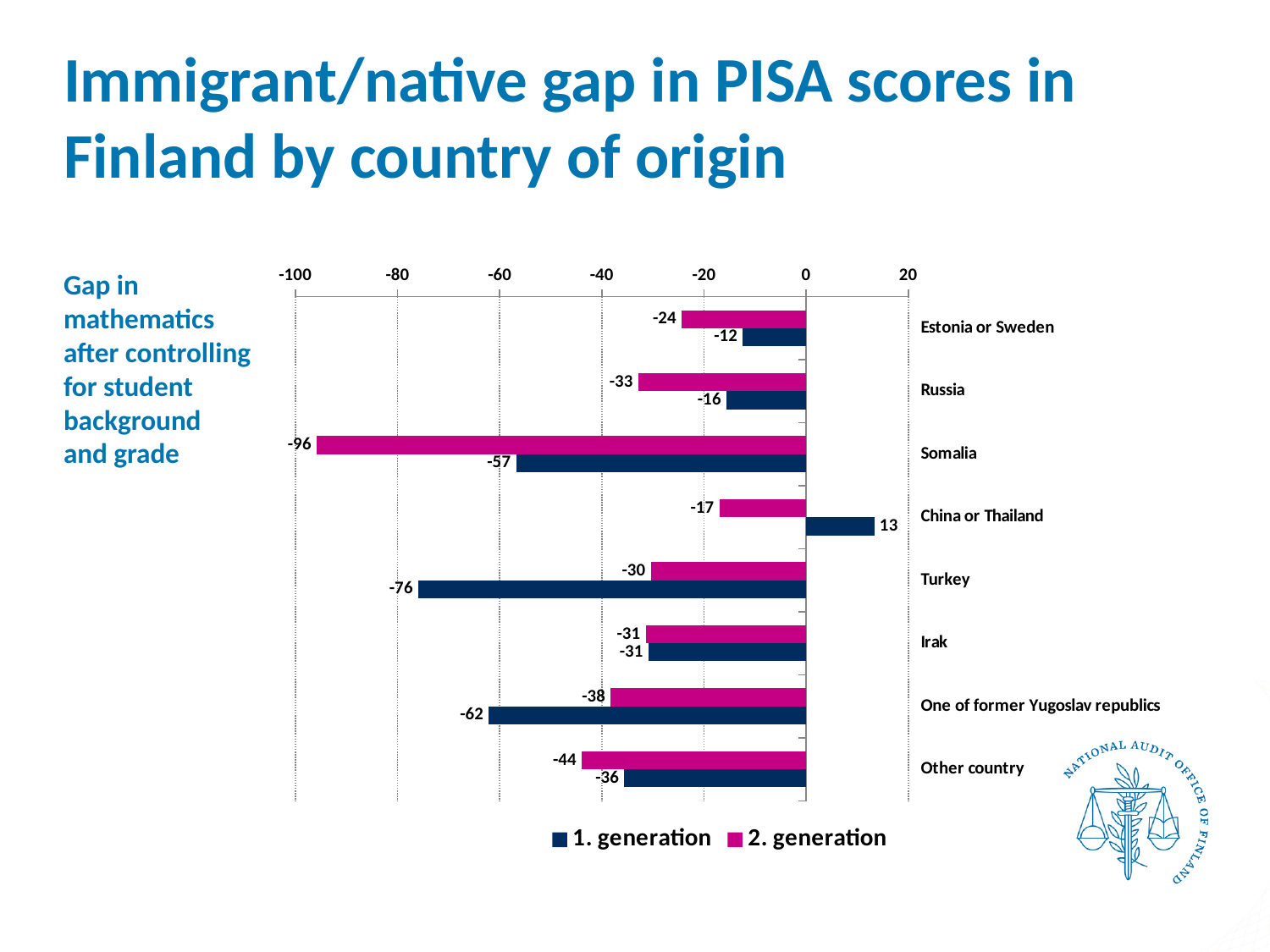
What is the 1. generation value for China or Thailand? 13 How many series does the legend list? 2 What kind of chart is shown on the slide? Bar chart What is the 2. generation value for Russia? -33 Which country of origin has the highest 1. generation value? China or Thailand What is the 1. generation value for Turkey? -76 Which is larger, the 1. generation value for Estonia or Sweden or the 1. generation value for Russia? Estonia or Sweden What is the difference between the 1. generation and 2. generation values for Somalia? 39 How many countries of origin are shown on the chart? 8 What is the 2. generation value for Somalia? -96 Which series is shown in magenta in the legend? 2. generation Which country of origin has the lowest 2. generation value? Somalia